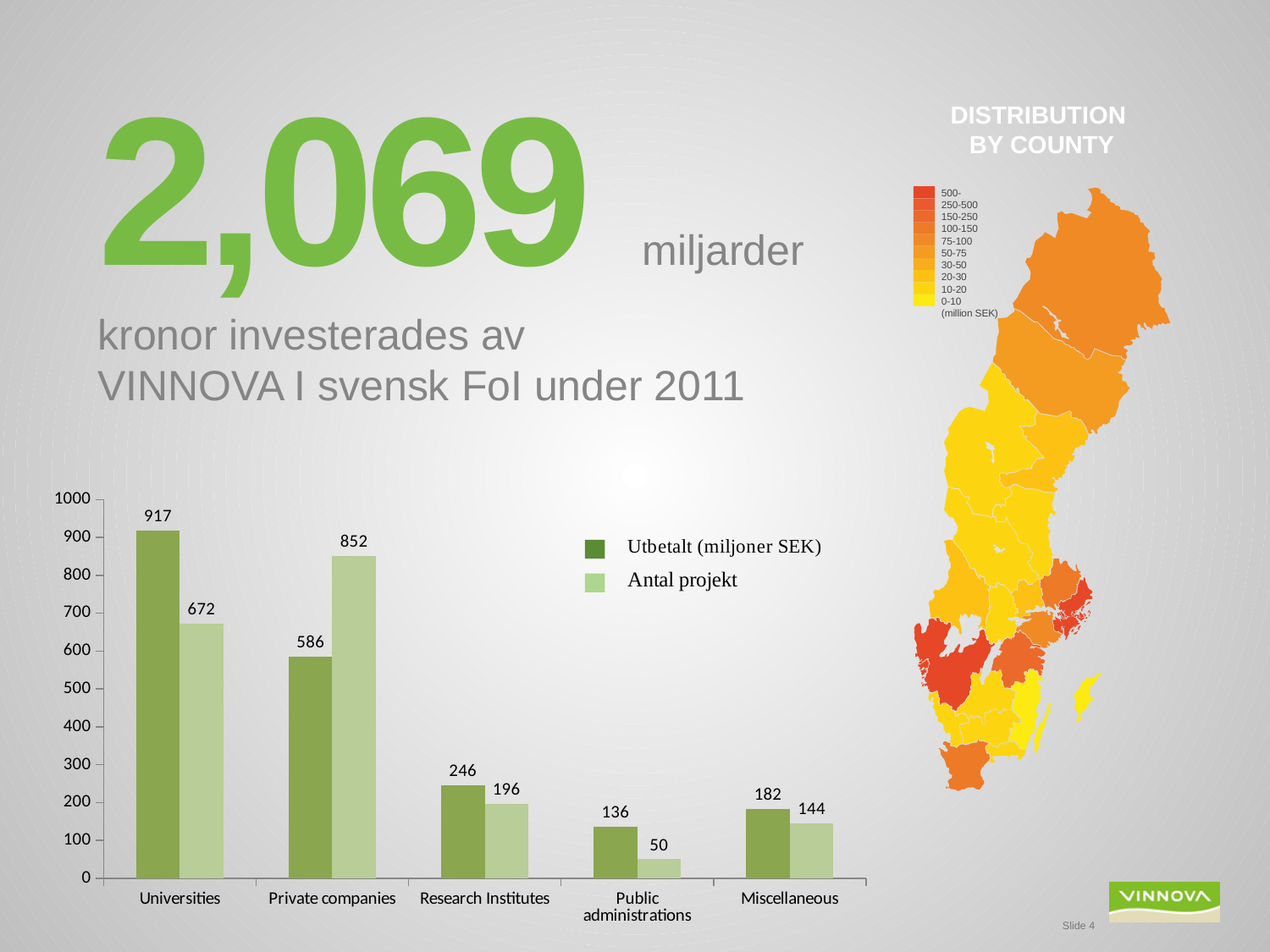
What is the difference between the Utbetalt (miljoner SEK) values for Universities and Private companies? 331 How many series does the legend of the bar chart list? 2 What is the title of the map on the right side of the slide? DISTRIBUTION BY COUNTY What kind of chart is used to show Utbetalt and Antal projekt by category? Bar chart How many categories are shown on the x axis of the bar chart? 5 What is the difference between the Antal projekt values for Miscellaneous and Public administrations? 94 What is the Antal projekt value for Private companies? 852 What is the Utbetalt (miljoner SEK) value for Universities? 917 Which category has the lowest Antal projekt value? Public administrations Which is larger for Research Institutes: Utbetalt (miljoner SEK) or Antal projekt? Utbetalt (miljoner SEK) What is the Antal projekt value for Public administrations? 50 Which category has the highest Utbetalt (miljoner SEK) value? Universities